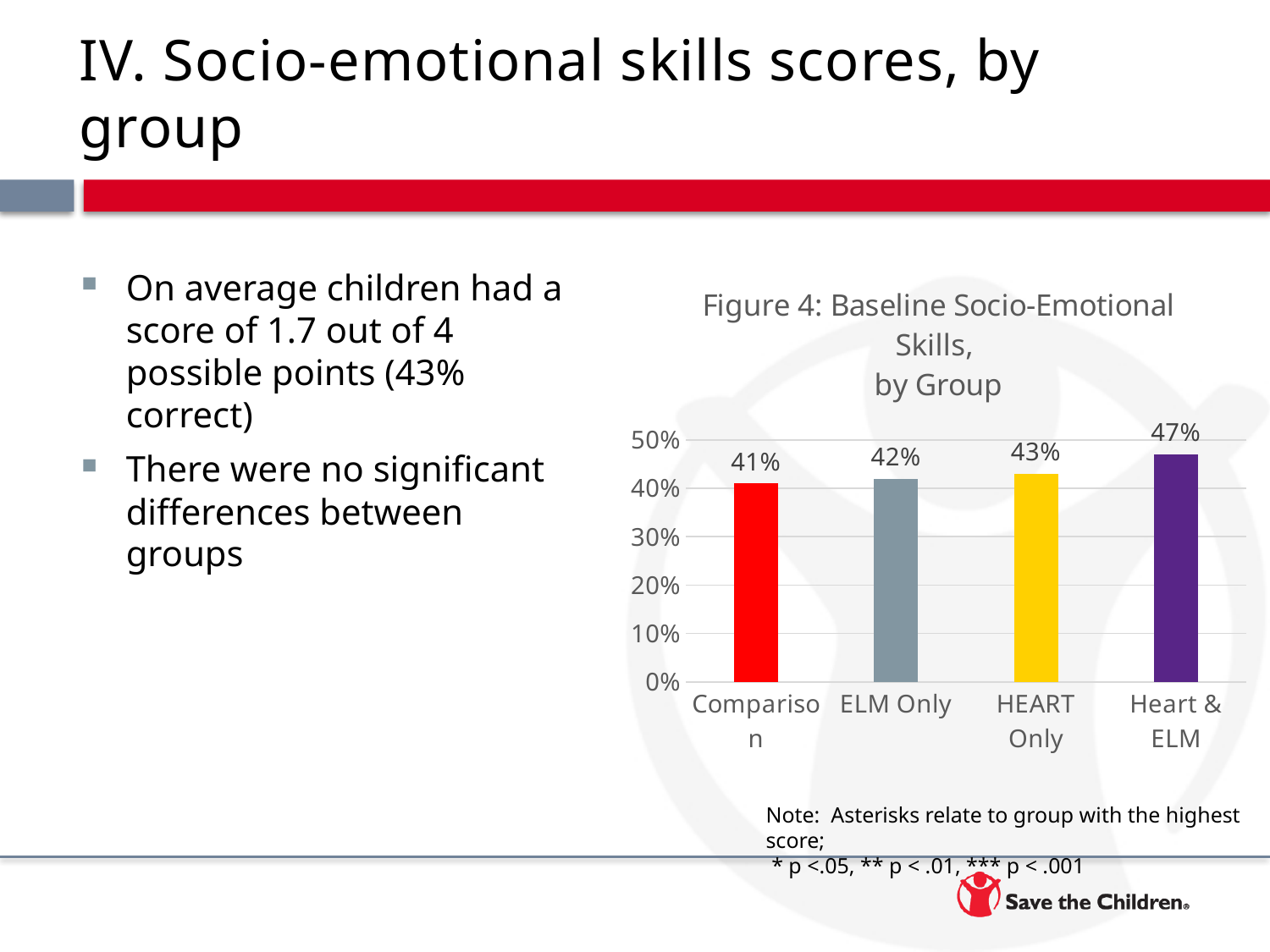
Is the value for Heart & ELM greater or less than 50%? less Which group has the highest baseline socio-emotional skills score? Heart & ELM What is the value for the ELM Only group? 42% What is the value for the HEART Only group? 43% How many groups are shown on the chart? 4 What is the value for the Heart & ELM group? 47% Which is larger, the value for HEART Only or the value for ELM Only? HEART Only What kind of chart is shown on the slide? Bar chart What is the title of the chart? Figure 4: Baseline Socio-Emotional Skills, by Group What is the value for the Comparison group? 41% What is the difference between the Heart & ELM value and the Comparison value? 6% Which group has the lowest baseline socio-emotional skills score? Comparison